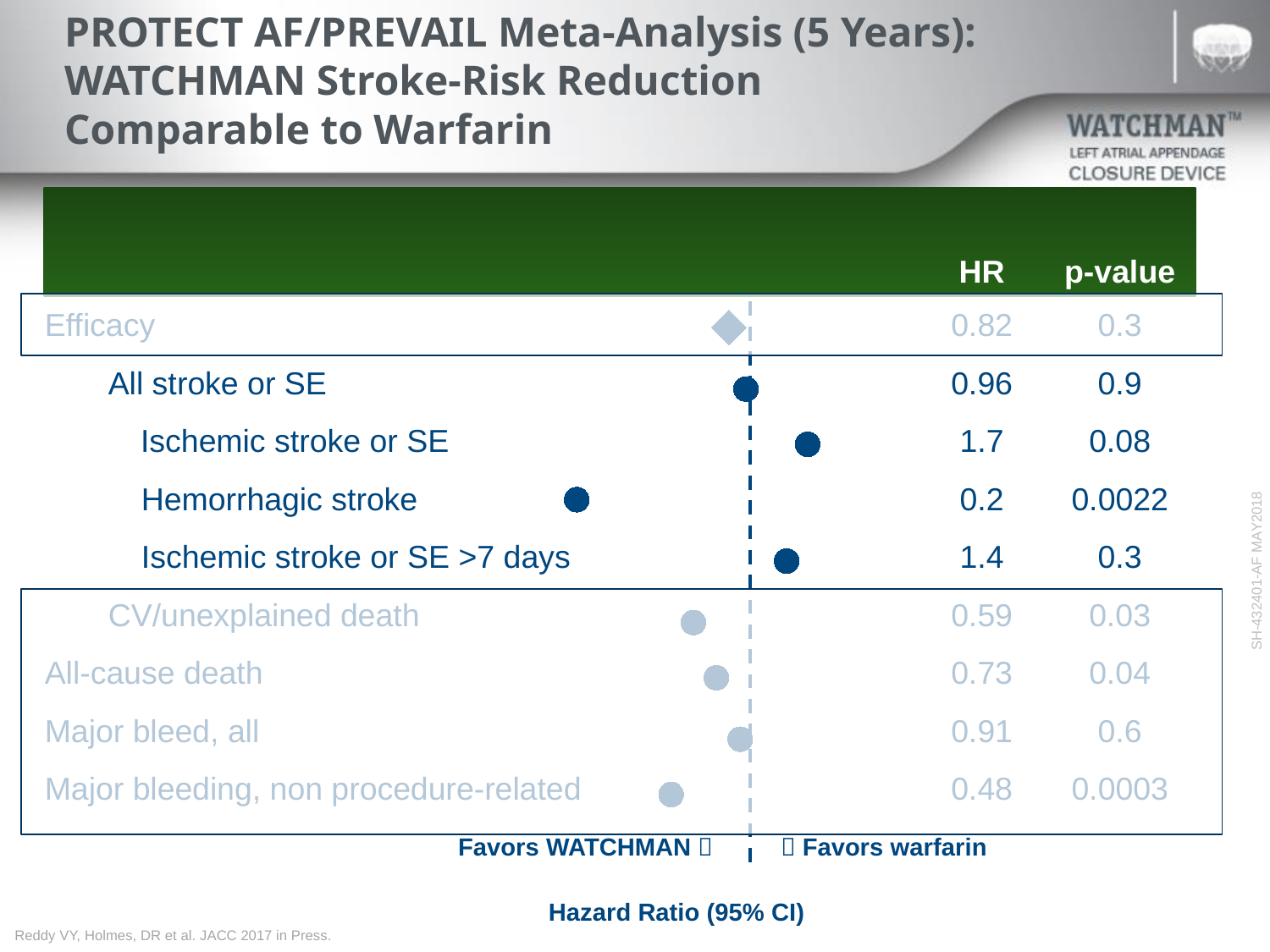
Is the HR for Ischemic stroke or SE >7 days greater or less than 1? greater What is the p-value for All-cause death? 0.04 What is the hazard ratio (HR) for Hemorrhagic stroke? 0.2 What is the p-value for Ischemic stroke or SE? 0.08 Which outcome has the lowest hazard ratio? Hemorrhagic stroke What is the HR for Major bleeding, non procedure-related? 0.48 Which has the larger HR, All-cause death or CV/unexplained death? All-cause death Which outcome has the highest hazard ratio? Ischemic stroke or SE Which outcome has the smallest p-value? Major bleeding, non procedure-related What is the x-axis label of the chart? Hazard Ratio (95% CI) What is the difference between the HR for Ischemic stroke or SE and the HR for Hemorrhagic stroke? 1.5 How many outcomes are plotted in the chart? 9